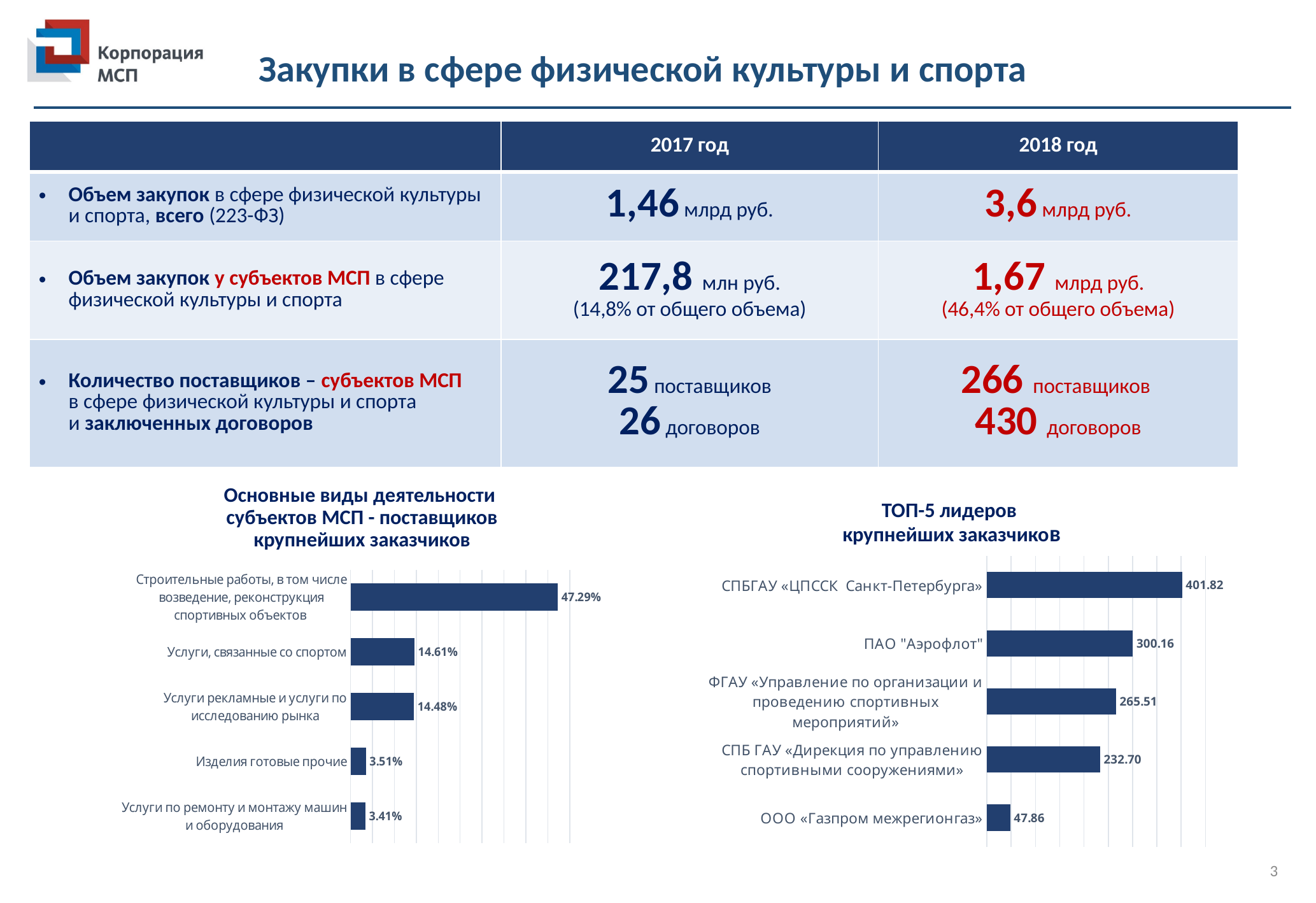
In the chart 'Основные виды деятельности субъектов МСП - поставщиков крупнейших заказчиков', how many categories are shown? 5 In the chart 'ТОП-5 лидеров крупнейших заказчиков', what is the difference between СПБГАУ «ЦПССК Санкт-Петербурга» and ПАО "Аэрофлот"? 101.66 In the chart 'Основные виды деятельности субъектов МСП - поставщиков крупнейших заказчиков', what is the value for 'Услуги, связанные со спортом'? 14.61% In the chart 'Основные виды деятельности субъектов МСП - поставщиков крупнейших заказчиков', what is the difference between 'Услуги, связанные со спортом' and 'Услуги рекламные и услуги по исследованию рынка'? 0.13% What type of chart is 'Основные виды деятельности субъектов МСП - поставщиков крупнейших заказчиков'? Bar chart In the chart 'Основные виды деятельности субъектов МСП - поставщиков крупнейших заказчиков', which category has the highest value? Строительные работы, в том числе возведение, реконструкция спортивных объектов In the chart 'Основные виды деятельности субъектов МСП - поставщиков крупнейших заказчиков', which category has the lowest value? Услуги по ремонту и монтажу машин и оборудования In the chart 'ТОП-5 лидеров крупнейших заказчиков', which customer has the highest value? СПБГАУ «ЦПССК Санкт-Петербурга» In the chart 'ТОП-5 лидеров крупнейших заказчиков', what is the value for ООО «Газпром межрегионгаз»? 47.86 In the chart 'ТОП-5 лидеров крупнейших заказчиков', how many customers are listed? 5 In the chart 'ТОП-5 лидеров крупнейших заказчиков', what is the value for ПАО "Аэрофлот"? 300.16 In the chart 'ТОП-5 лидеров крупнейших заказчиков', which is larger: the value for ФГАУ «Управление по организации и проведению спортивных мероприятий» or for СПБ ГАУ «Дирекция по управлению спортивными сооружениями»? ФГАУ «Управление по организации и проведению спортивных мероприятий»